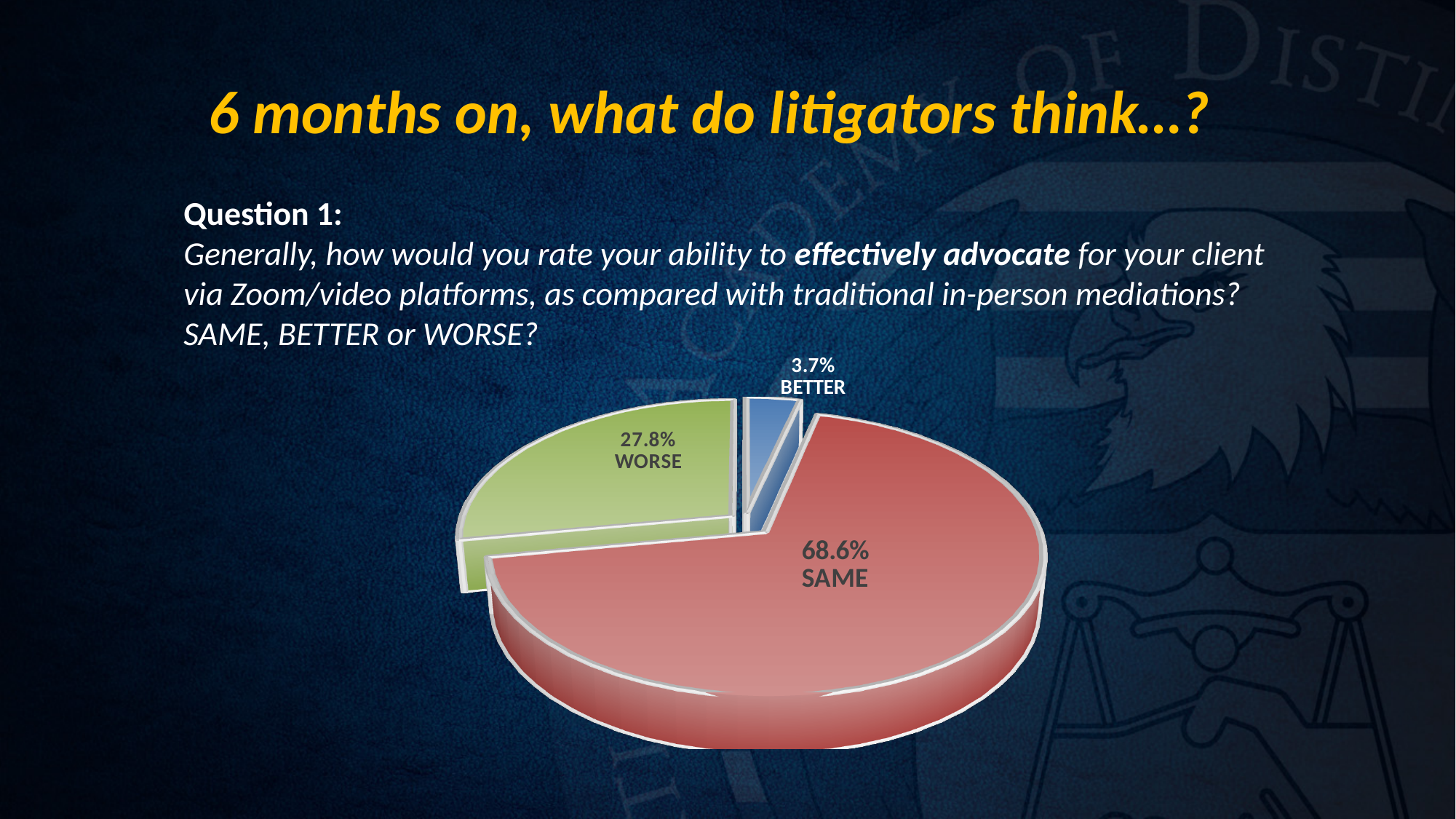
What percentage of litigators answered BETTER? 3.7% Which response has the smallest share of the pie? BETTER What kind of chart is shown on the slide? Pie chart Which is larger, the share for WORSE or the share for BETTER? WORSE What percentage of litigators answered SAME? 68.6% What is the difference in percentage points between WORSE and BETTER? 24.1 What percentage of litigators answered WORSE? 27.8% What colour is the WORSE slice of the pie? Green What is the difference in percentage points between SAME and WORSE? 40.8 Which response has the largest share of the pie? SAME How many slices does the pie chart have? 3 What colour is the SAME slice of the pie? Red